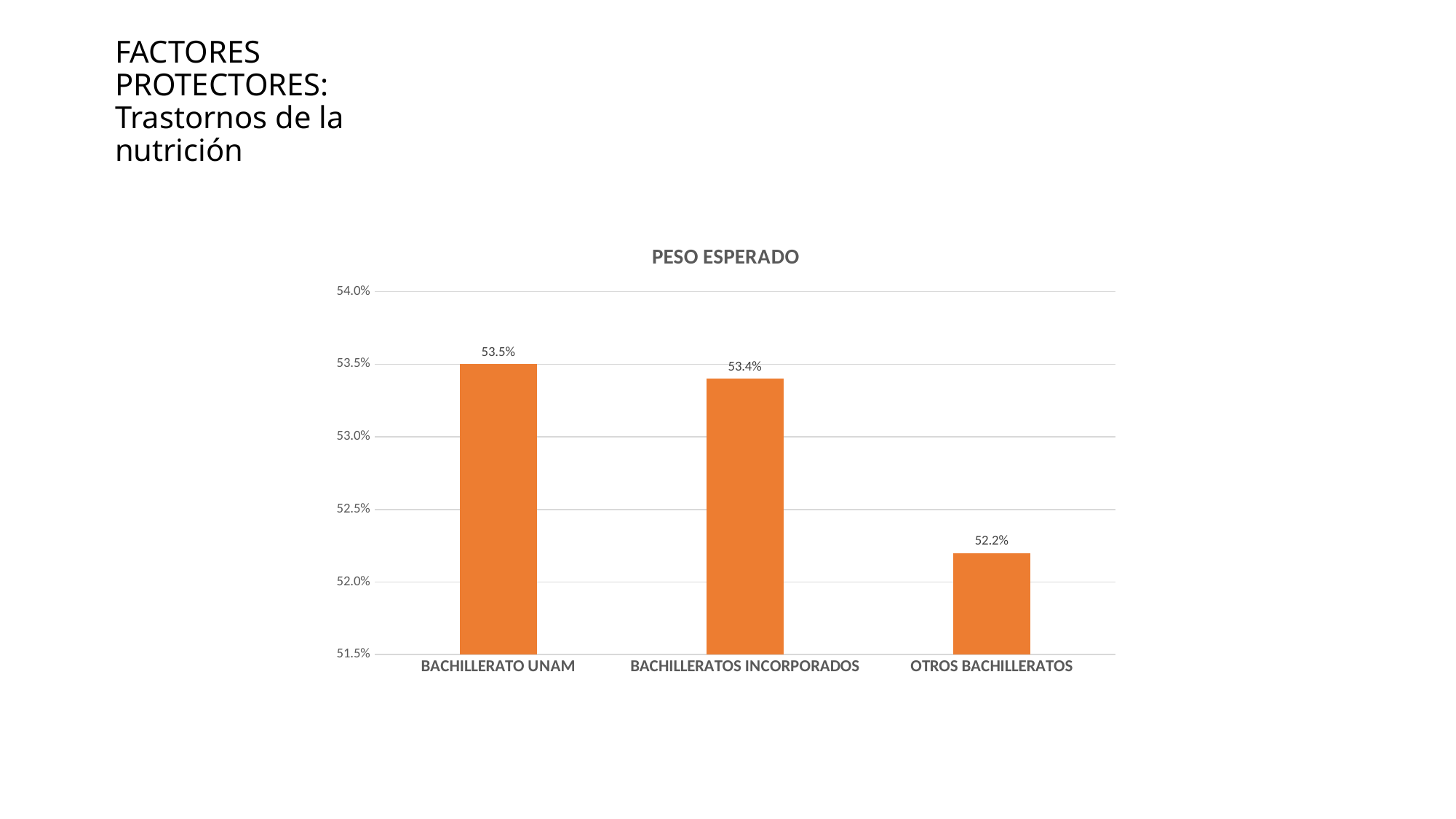
Is the value for OTROS BACHILLERATOS greater or less than 52.5%? less What is the difference between the values for BACHILLERATO UNAM and OTROS BACHILLERATOS? 1.3% What is the difference between the values for BACHILLERATOS INCORPORADOS and OTROS BACHILLERATOS? 1.2% Which is larger, the value for BACHILLERATOS INCORPORADOS or the value for OTROS BACHILLERATOS? BACHILLERATOS INCORPORADOS What kind of chart is shown on the slide? Bar chart Is the value for BACHILLERATO UNAM greater or less than 53.0%? greater Which category has the lowest value? OTROS BACHILLERATOS What is the value for BACHILLERATOS INCORPORADOS? 53.4% How many categories are shown on the chart? 3 What is the title of the chart? PESO ESPERADO What is the value for BACHILLERATO UNAM? 53.5% What is the value for OTROS BACHILLERATOS? 52.2%